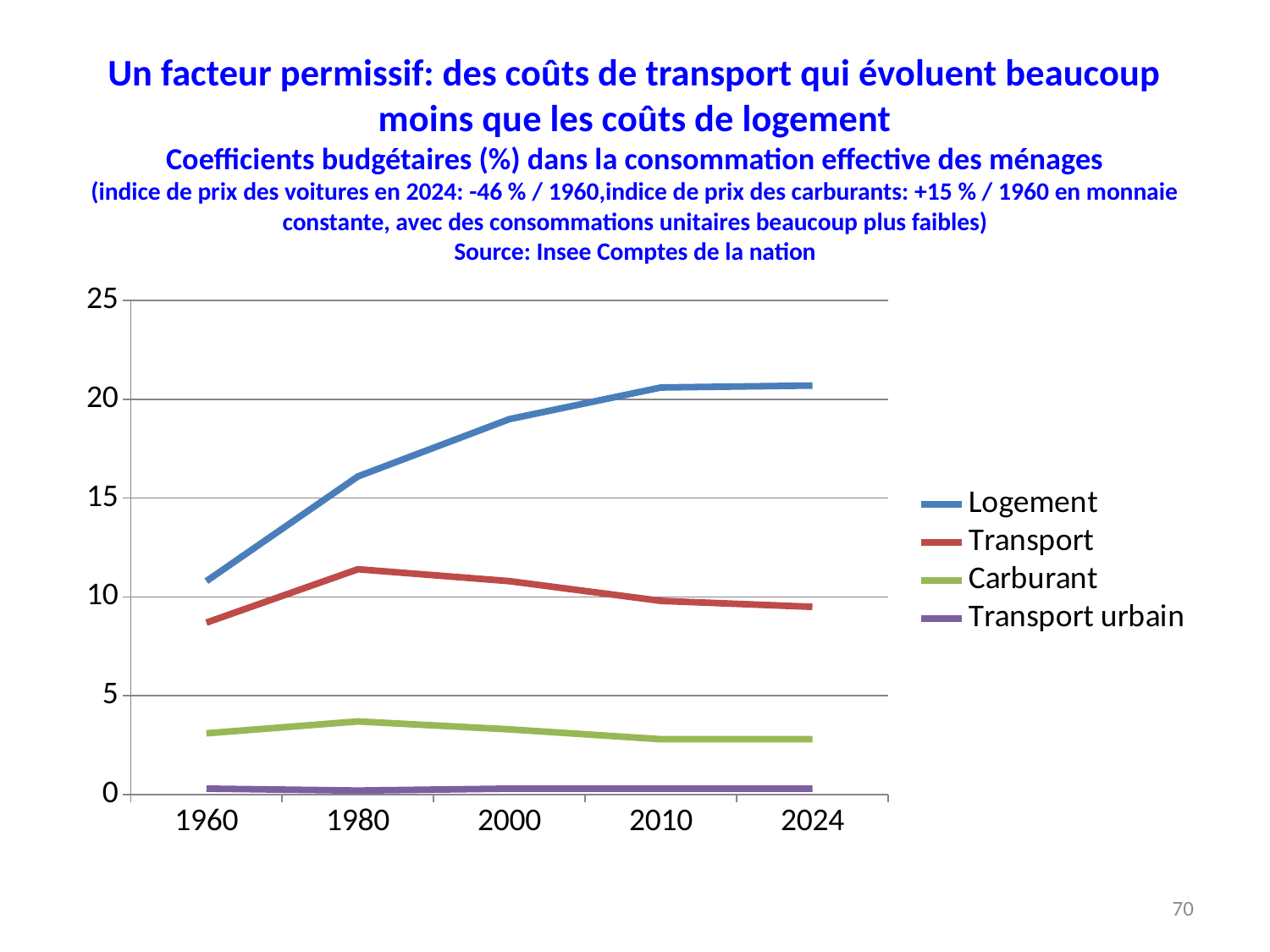
Is the value for Carburant in 2024 greater or less than 5? less How many series does the legend list? 4 Which is larger in 2024, Logement or Transport? Logement What colour is the Logement line in the legend? blue Which series has the lowest value across all years shown? Transport urbain Which series has the highest value in 2024? Logement Does the Logement series rise or fall from 1960 to 2024? rise Is the value for Transport in 1980 greater or less than 10? greater What kind of chart is shown on the slide? line chart How many years are shown on the x axis? 5 Which is larger in 1980, Carburant or Transport urbain? Carburant Is the value for Logement in 2024 greater or less than 20? greater